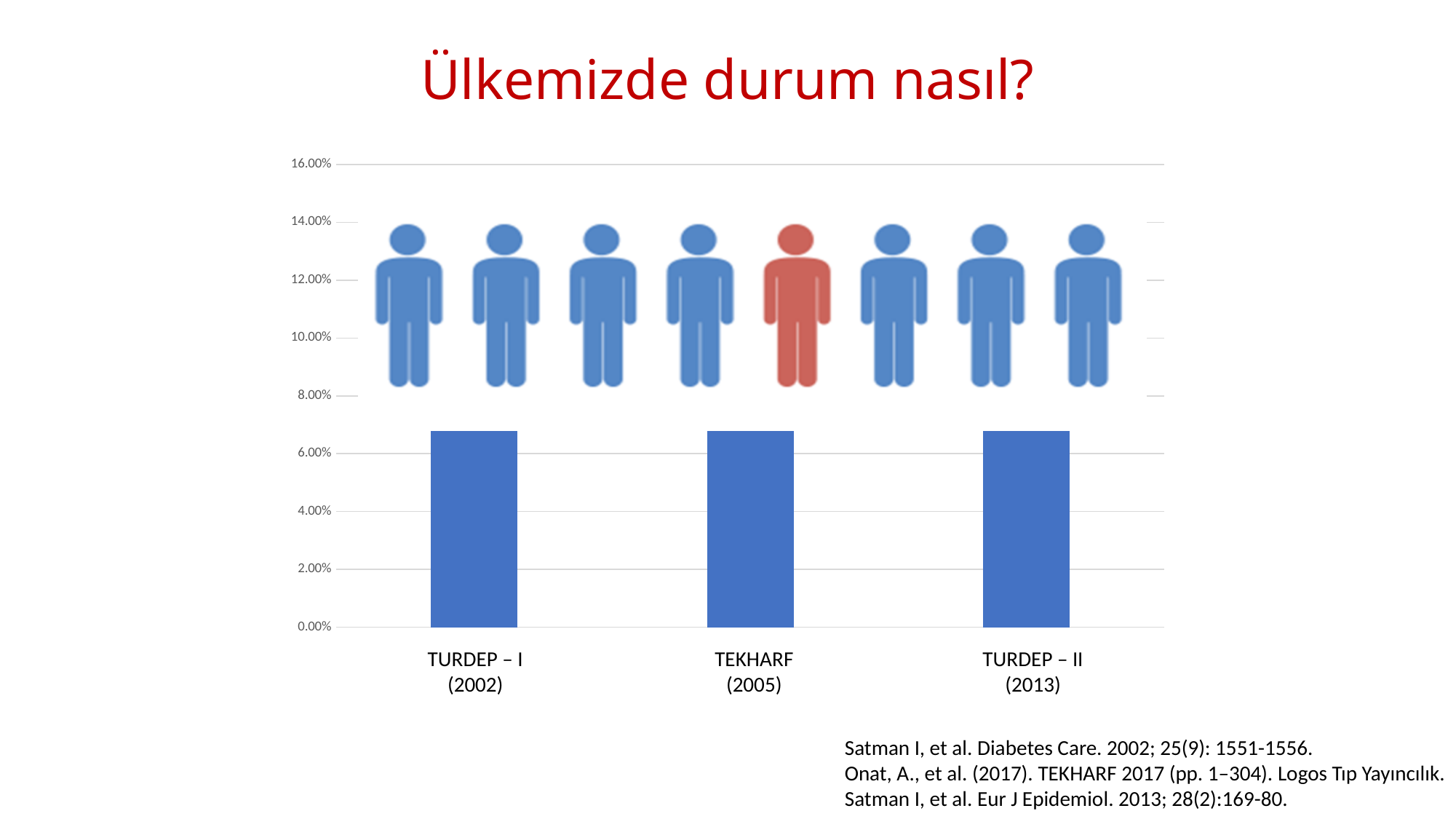
How many categories (bars) does the chart show? 3 What is the highest value shown on the vertical axis? 16.00% Is the value for TEKHARF (2005) greater or less than 6.00%? greater What kind of chart is shown on the slide? bar chart Is the value for TURDEP – I (2002) greater or less than 4.00%? greater Which category is plotted in the middle of the chart? TEKHARF (2005) What is the title of the slide? Ülkemizde durum nasıl? Is the value for TURDEP – I (2002) greater or less than 8.00%? less